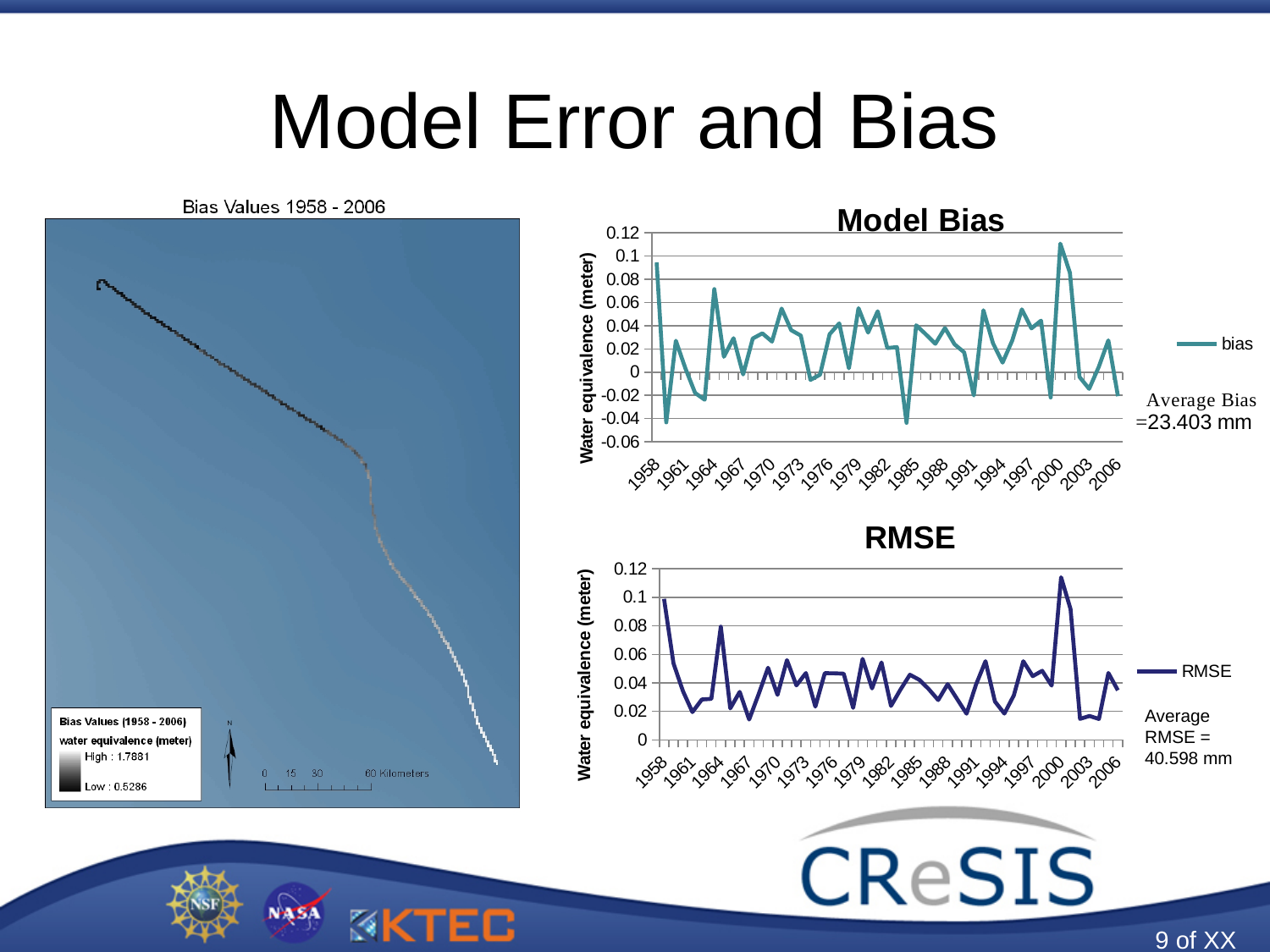
What is the legend entry of the RMSE chart? RMSE In the Model Bias chart, is the bias value for 1958 greater or less than 0.06? greater In the RMSE chart, which is larger, the RMSE value for 1964 or for 1967? 1964 What is the y-axis label of the Model Bias chart? Water equivalence (meter) What kind of chart is the Model Bias chart? line chart In the Model Bias chart, which year has the highest bias value? 2000 In the RMSE chart, is the RMSE value for 2000 greater or less than 0.1? greater In the Model Bias chart, is the bias value for 1985 greater or less than -0.02? greater What kind of chart is the RMSE chart? line chart How many series does the legend of the Model Bias chart list? 1